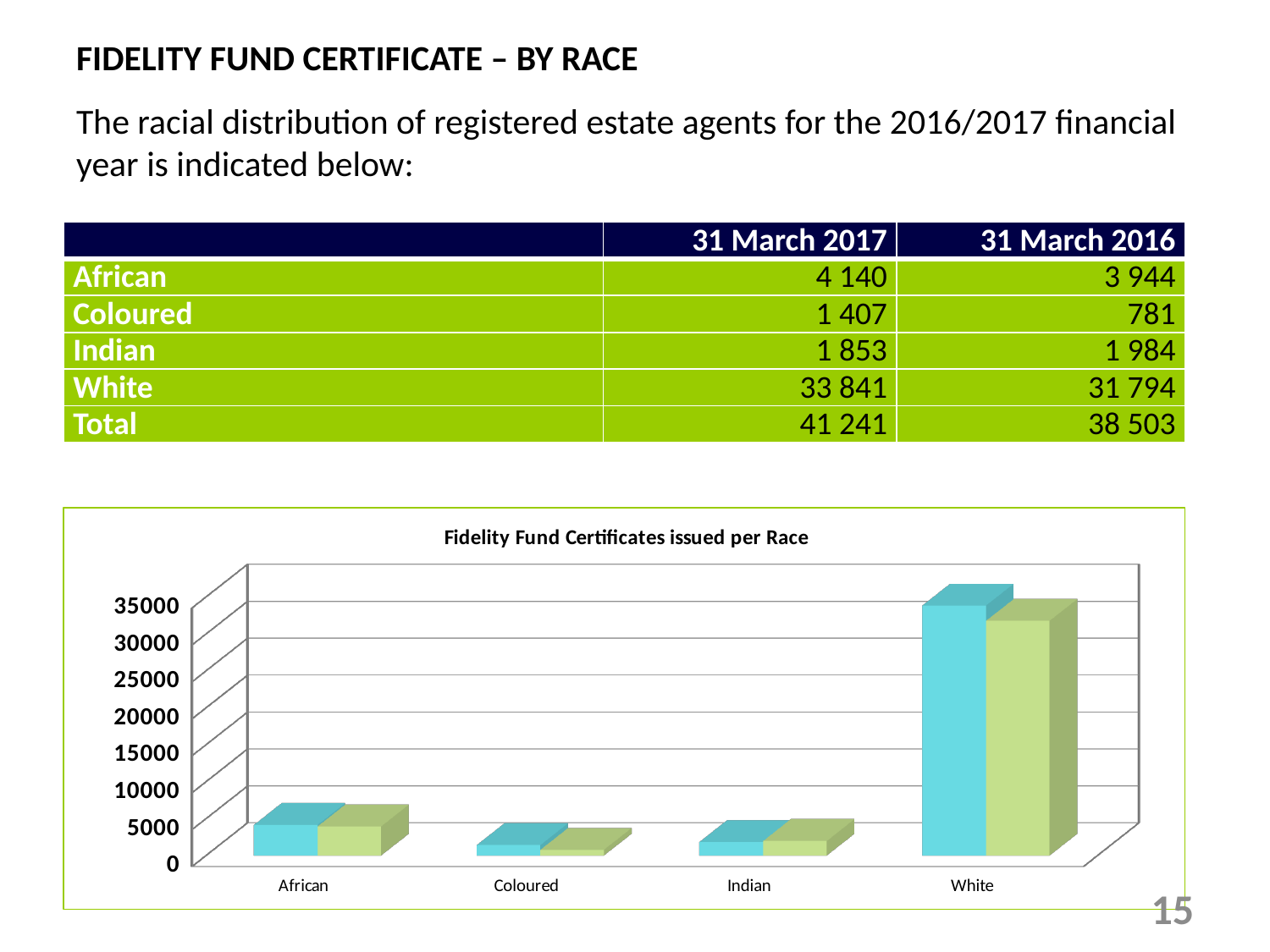
What kind of chart is shown on the slide? bar chart Are the bars for African greater or less than 5000? less Are the bars for Indian greater or less than 10000? less Which category has the highest bars in the chart? White Are the bars for Coloured greater or less than 5000? less How many race categories are shown on the x axis of the chart? 4 Which category has larger bars, Indian or Coloured? Indian What is the title of the chart? Fidelity Fund Certificates issued per Race Which category has the lowest bars in the chart? Coloured How many bars are shown for each race category in the chart? 2 Which category has larger bars, White or African? White